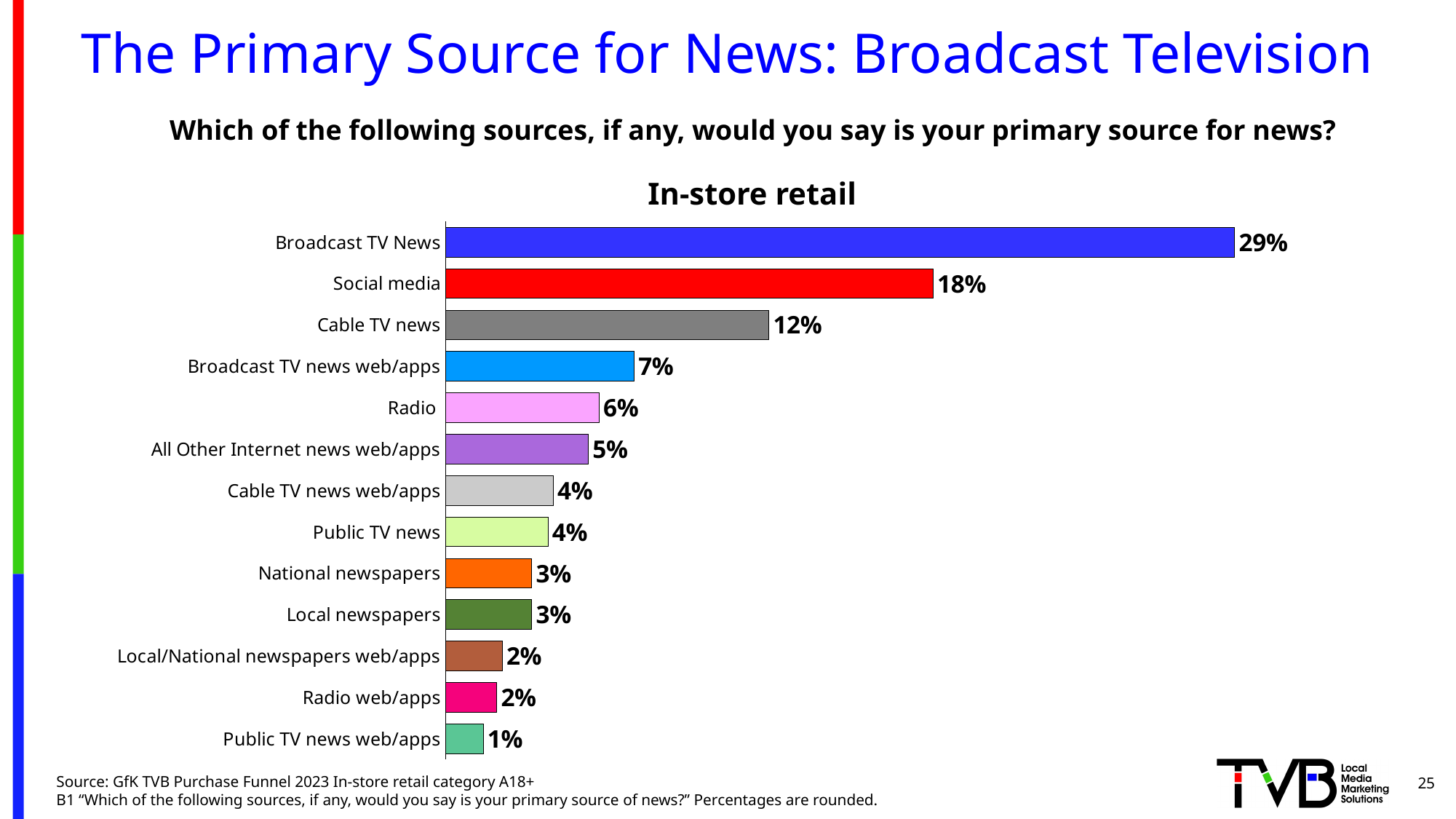
What percentage of respondents named Broadcast TV News as their primary source for news? 29% What colour is the bar for Social media? Red What is the value shown for Social media? 18% What is the title of the chart? In-store retail What type of chart is shown on the slide? Bar chart How many news sources are listed in the chart? 13 Which source has the lowest percentage in the chart? Public TV news web/apps What is the difference in percentage points between Broadcast TV News and Social media? 11 Which source has the highest percentage in the chart? Broadcast TV News Which has a larger value, Radio or All Other Internet news web/apps? Radio What percentage is shown for Cable TV news web/apps? 4% What is the difference in percentage points between Cable TV news and Broadcast TV news web/apps? 5